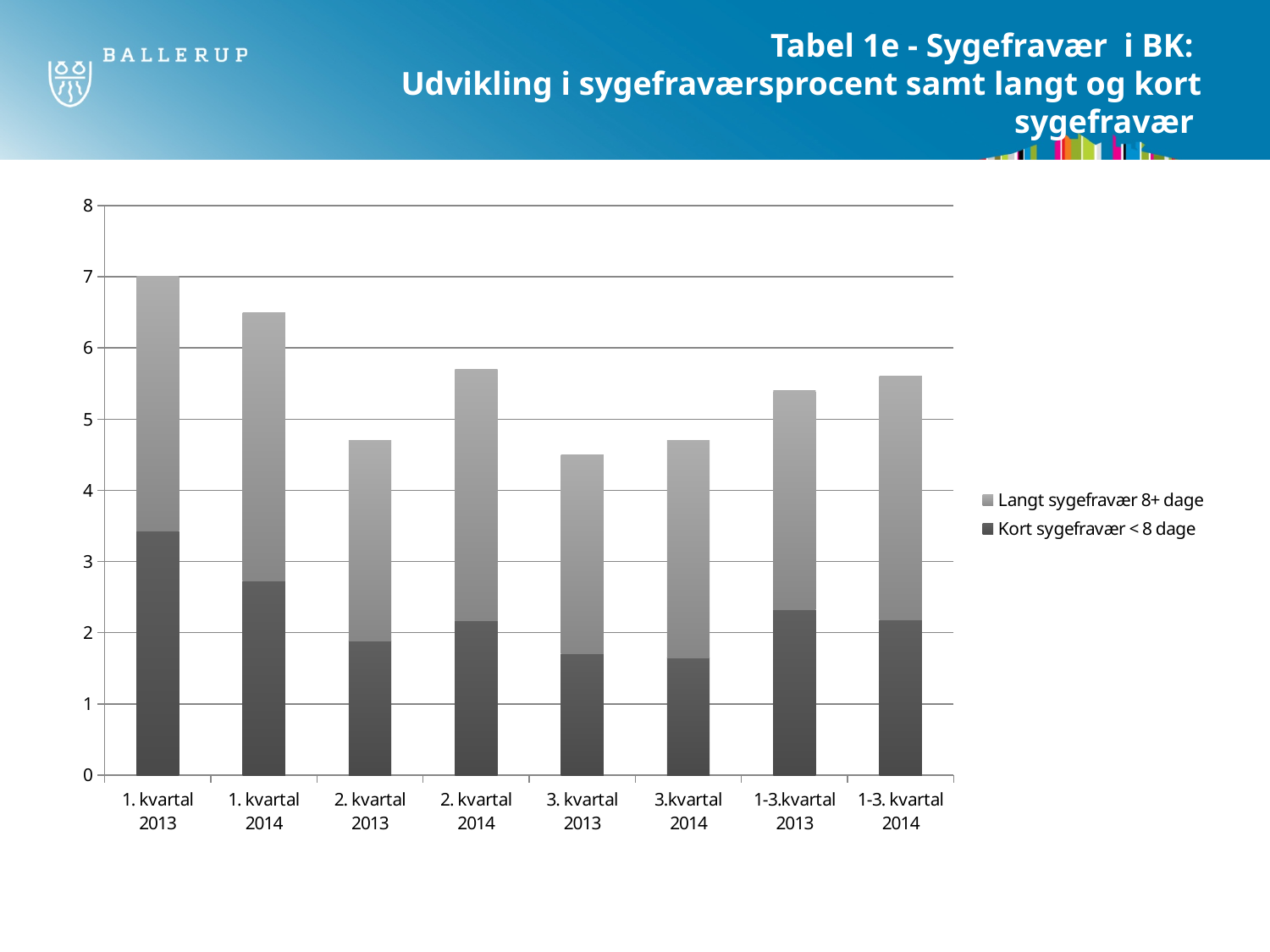
Is the total bar for 2. kvartal 2014 greater or less than 6? less Which has the larger total bar: 1. kvartal 2013 or 1. kvartal 2014? 1. kvartal 2013 How many series does the chart's legend list? 2 Is the 'Kort sygefravær < 8 dage' value for 2. kvartal 2013 greater or less than 2? less Is the total bar for 3. kvartal 2013 greater or less than 5? less Which series is shown in the lighter grey colour in the chart? Langt sygefravær 8+ dage Which category has the highest total bar in the chart? 1. kvartal 2013 What kind of chart is shown on the slide? Stacked bar chart How many categories are shown on the x axis of the chart? 8 Which has the larger 'Kort sygefravær < 8 dage' value: 1-3.kvartal 2013 or 3.kvartal 2014? 1-3.kvartal 2013